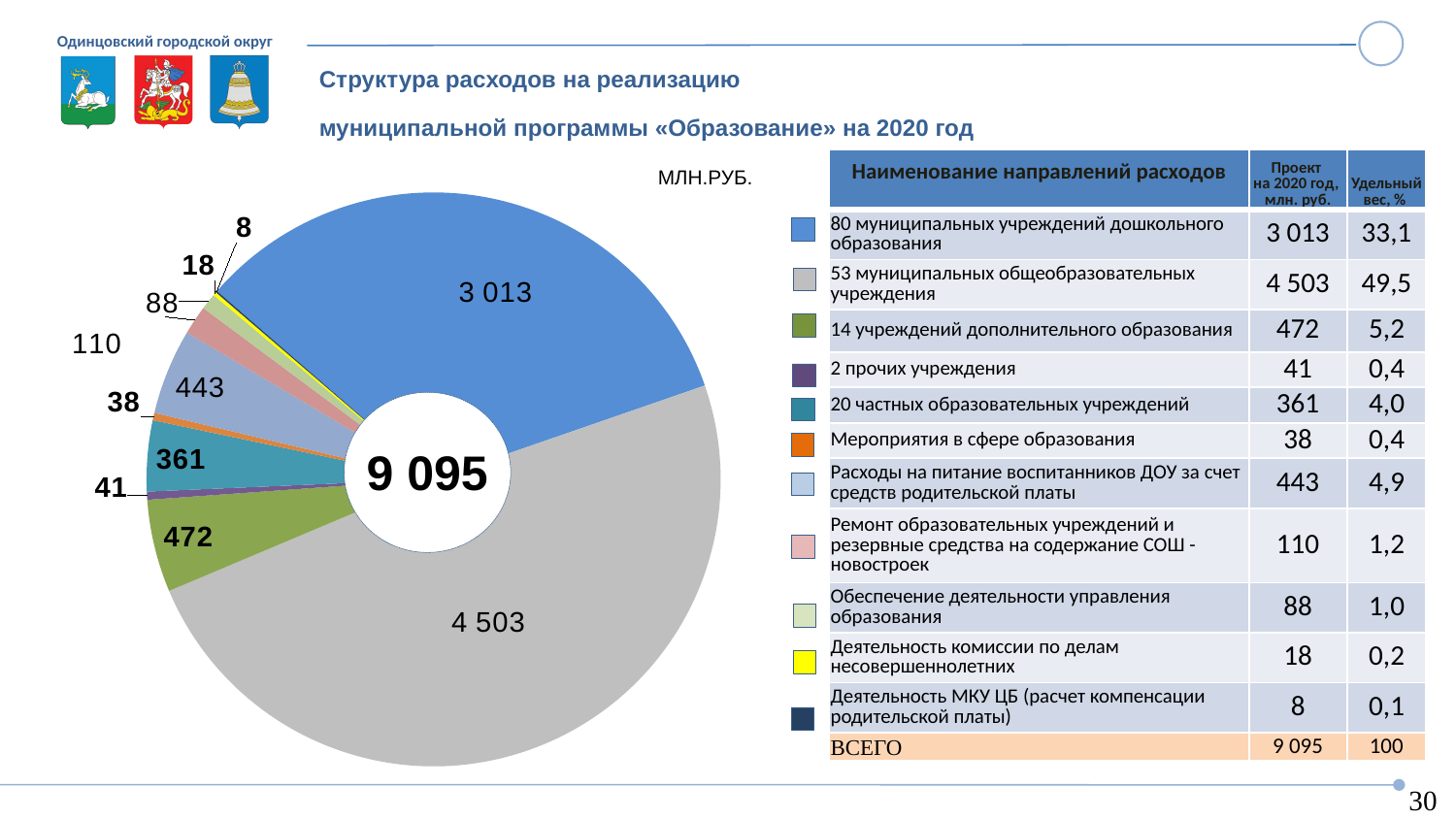
How many slices does the pie chart have? 11 Which category has the largest slice of the pie chart? 53 муниципальных общеобразовательных учреждения Which is larger: the value for 14 institutions of additional education or the value for meal expenses for preschool pupils (Расходы на питание воспитанников ДОУ)? 14 учреждений дополнительного образования (472) What is the value shown on the pie chart for the 80 municipal preschool institutions (80 муниципальных учреждений дошкольного образования)? 3 013 What unit is indicated above the pie chart? МЛН.РУБ. What is the value shown on the pie chart for the 20 private educational institutions (20 частных образовательных учреждений)? 361 What is the difference between the value for the 53 general education institutions (4 503) and the value for the 80 preschool institutions (3 013)? 1 490 What kind of chart is shown on the slide? Pie (doughnut) chart What share of the total do the 53 municipal general education institutions account for, according to the table? 49,5 What is the value shown on the pie chart for the 53 municipal general education institutions (53 муниципальных общеобразовательных учреждения)? 4 503 What total value is shown in the centre of the pie chart? 9 095 Which category has the smallest slice of the pie chart? Деятельность МКУ ЦБ (расчет компенсации родительской платы)